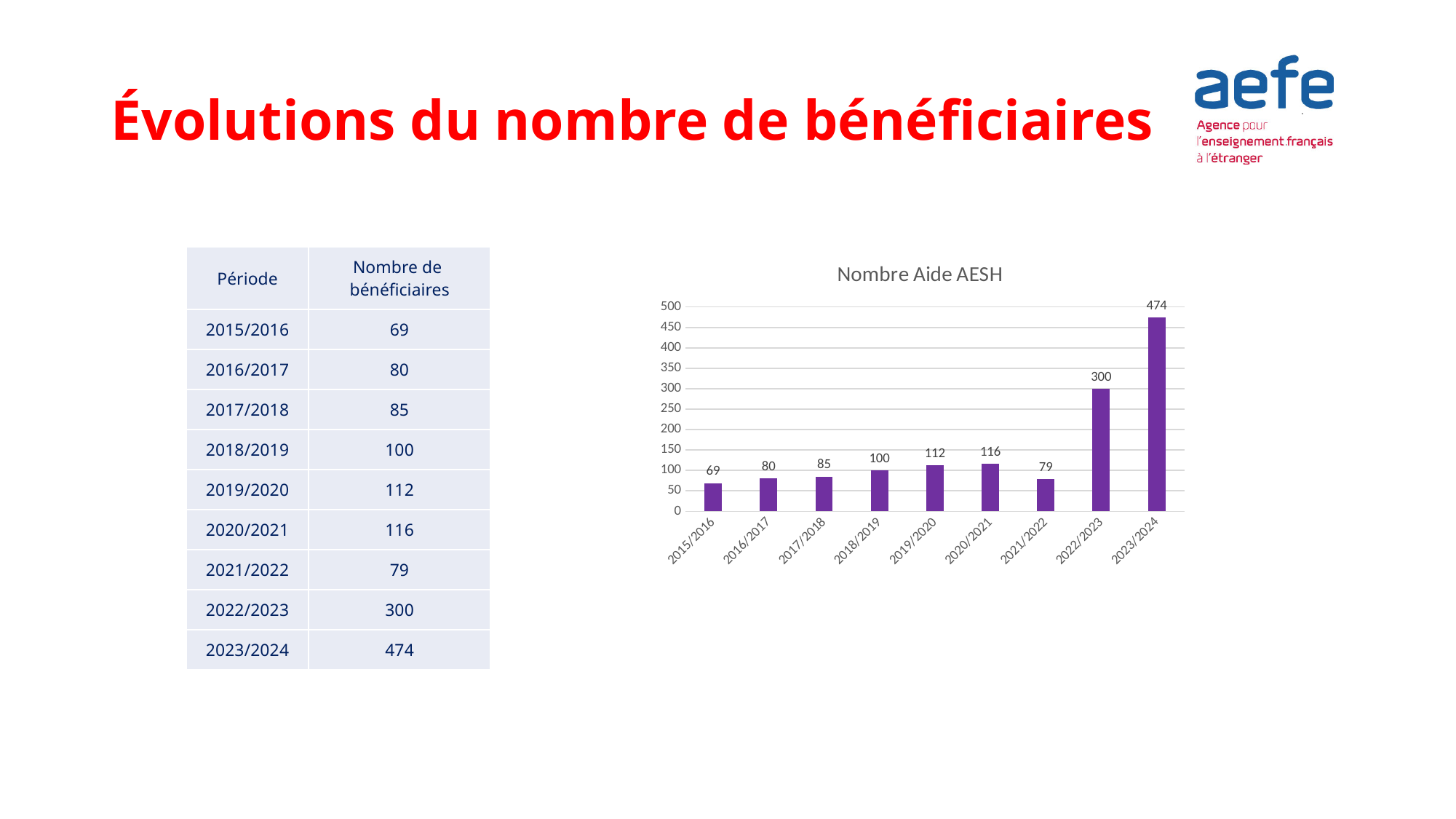
What is the value for 2018/2019 in the chart? 100 What is the title of the chart? Nombre Aide AESH What is the difference between the values for 2023/2024 and 2022/2023? 174 Which period has the lowest value in the chart? 2015/2016 Does the value rise or fall from 2022/2023 to 2023/2024? rise Which period has the highest value in the chart? 2023/2024 What kind of chart is shown on the slide? bar chart Is the value for 2022/2023 greater or less than 250? greater How many periods are shown on the x axis of the chart? 9 What is the value for 2023/2024 in the chart? 474 Which is larger, the value for 2020/2021 or the value for 2021/2022? 2020/2021 What is the value for 2021/2022 in the chart? 79